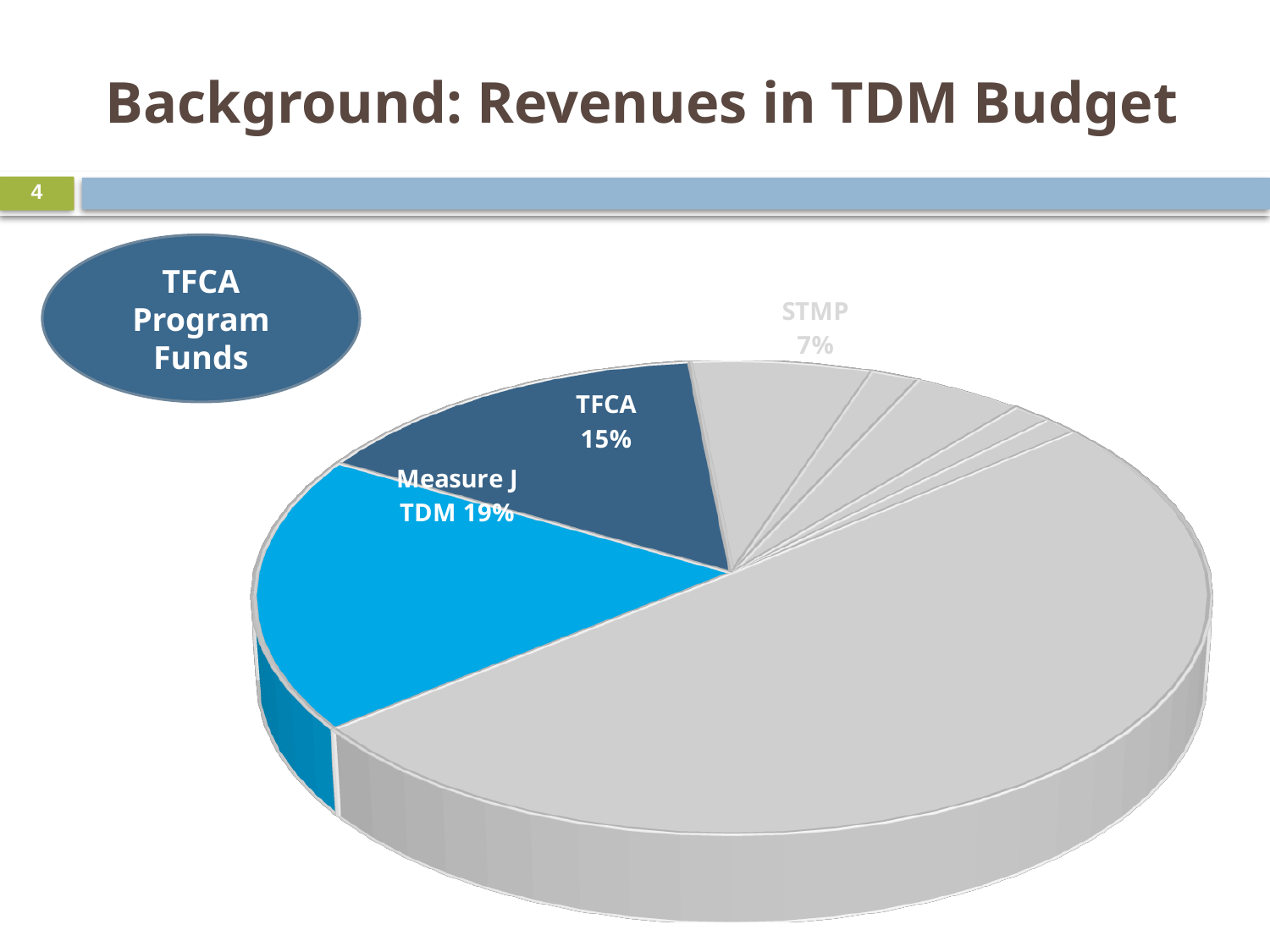
Among the labeled slices, which has the smallest share? STMP Among the labeled slices, which has the largest share? Measure J TDM What percentage of the pie does the Measure J TDM slice represent? 19% What is the difference in percentage points between the TFCA slice and the STMP slice? 8 percentage points What colour is the TFCA slice of the pie? Dark blue What is the difference in percentage points between the Measure J TDM slice and the TFCA slice? 4 percentage points What percentage of the pie does the TFCA slice represent? 15% What kind of chart is shown on the slide? Pie chart Which is larger, the STMP slice or the TFCA slice? TFCA Which is larger, the TFCA slice or the Measure J TDM slice? Measure J TDM What is the title of the slide containing the chart? Background: Revenues in TDM Budget What percentage of the pie does the STMP slice represent? 7%